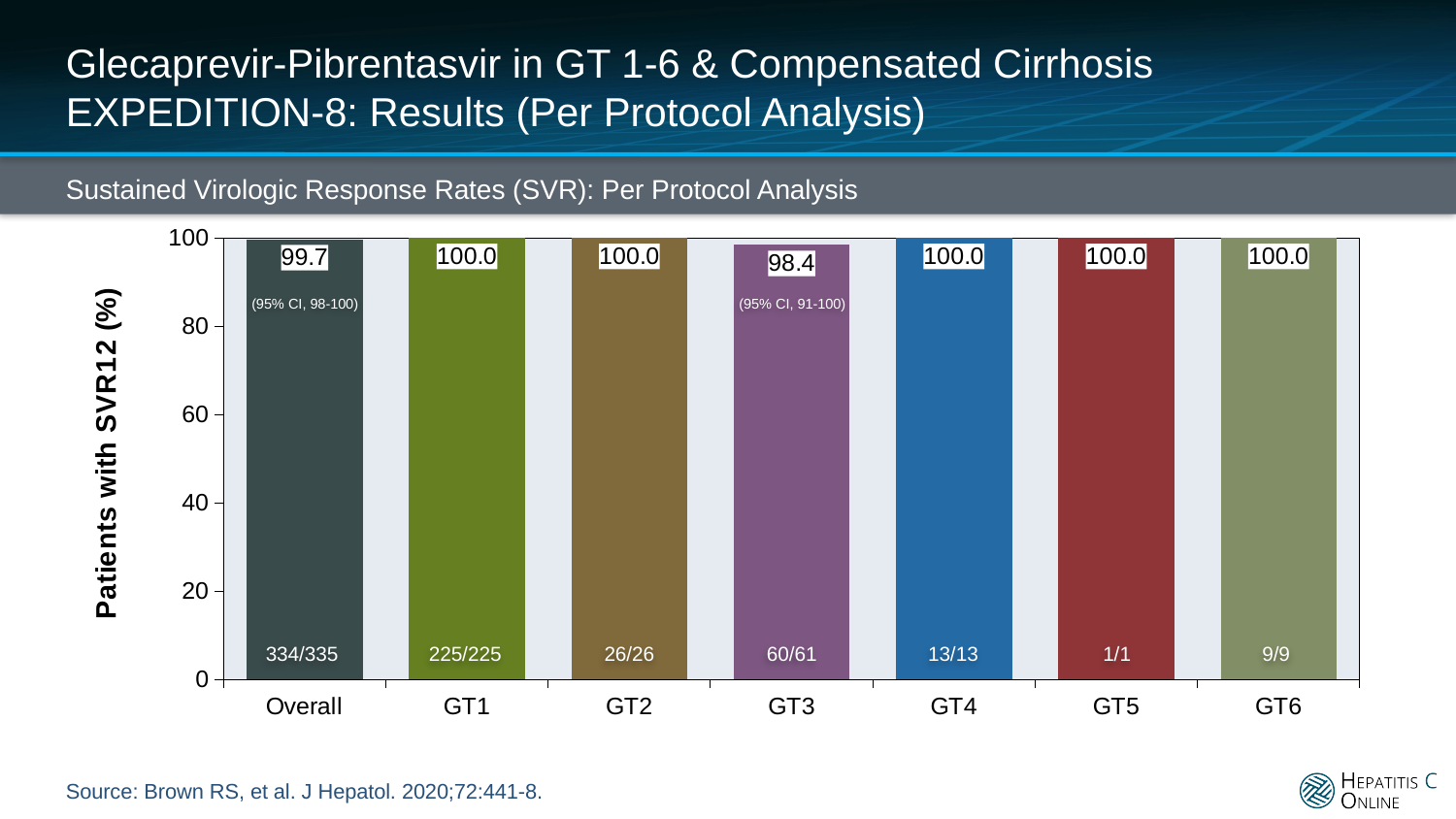
What is the SVR12 rate for GT1? 100.0 How many categories are shown on the x axis? 7 What kind of chart is shown? Bar chart What is the difference in SVR12 rate between GT1 and GT3? 1.6 What fraction of patients achieved SVR12 in GT3? 60/61 Which genotype group has the lowest SVR12 rate? GT3 What is the SVR12 rate for GT3? 98.4 What is the y-axis label of the chart? Patients with SVR12 (%) What is the 95% confidence interval shown for GT3? 91-100 Which is larger, the SVR12 rate for Overall or for GT3? Overall What fraction of patients achieved SVR12 in the Overall group? 334/335 What is the SVR12 rate for the Overall group? 99.7